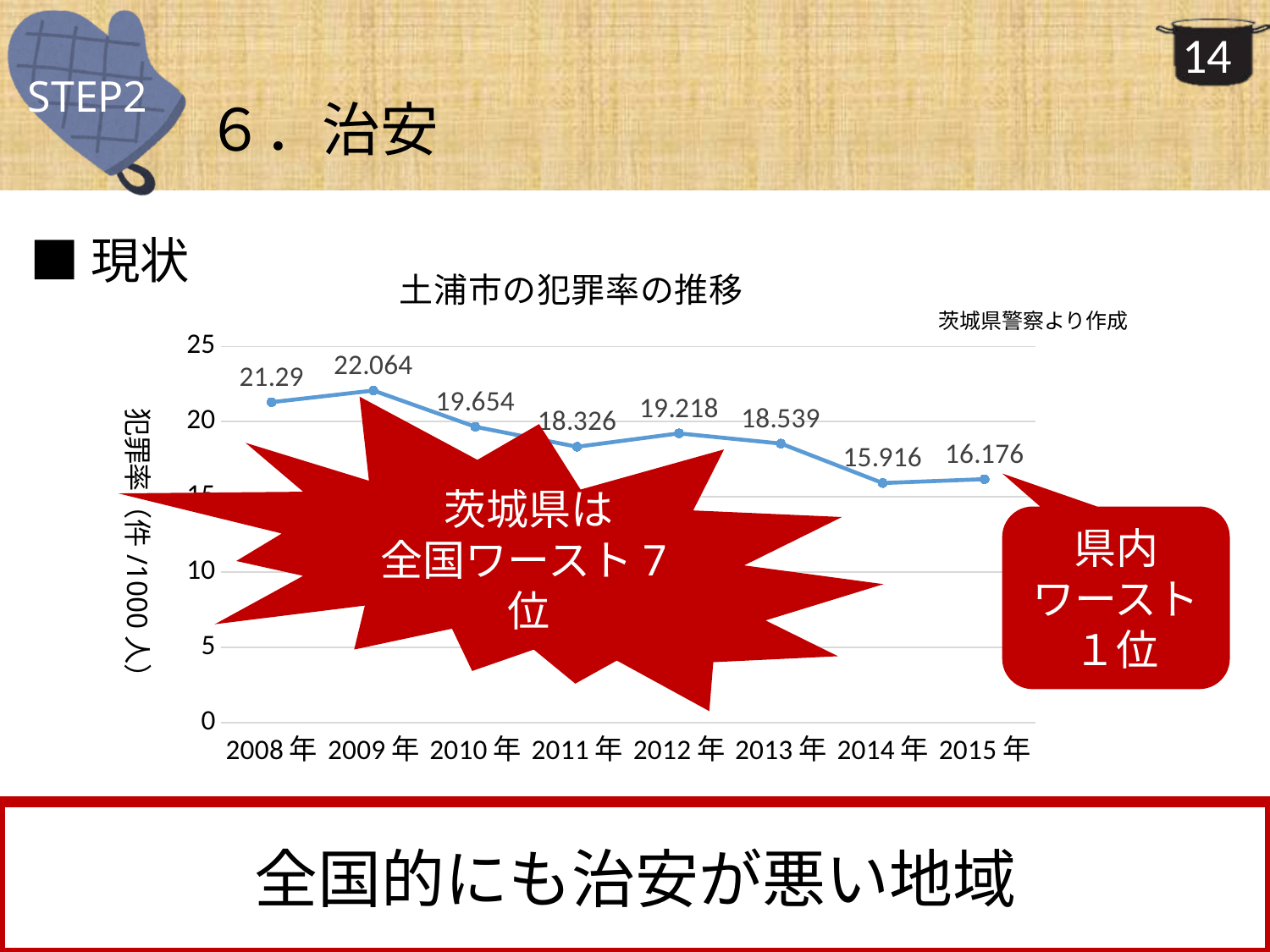
Which is larger, the crime rate in 2010年 or in 2013年? 2010年 How many years are plotted on the x axis? 8 What is the crime rate value for 2008年? 21.29 Overall, does the crime rate rise or fall from 2008年 to 2015年? fall What is the title of the chart? 土浦市の犯罪率の推移 Which year has the highest crime rate? 2009年 What is the crime rate value for 2012年? 19.218 Is the value for 2011年 greater or less than 20? less What is the difference between the crime rate in 2009年 and 2014年? 6.148 Which year has the lowest crime rate? 2014年 What is the crime rate value for 2015年? 16.176 What type of chart is shown on the slide? line chart